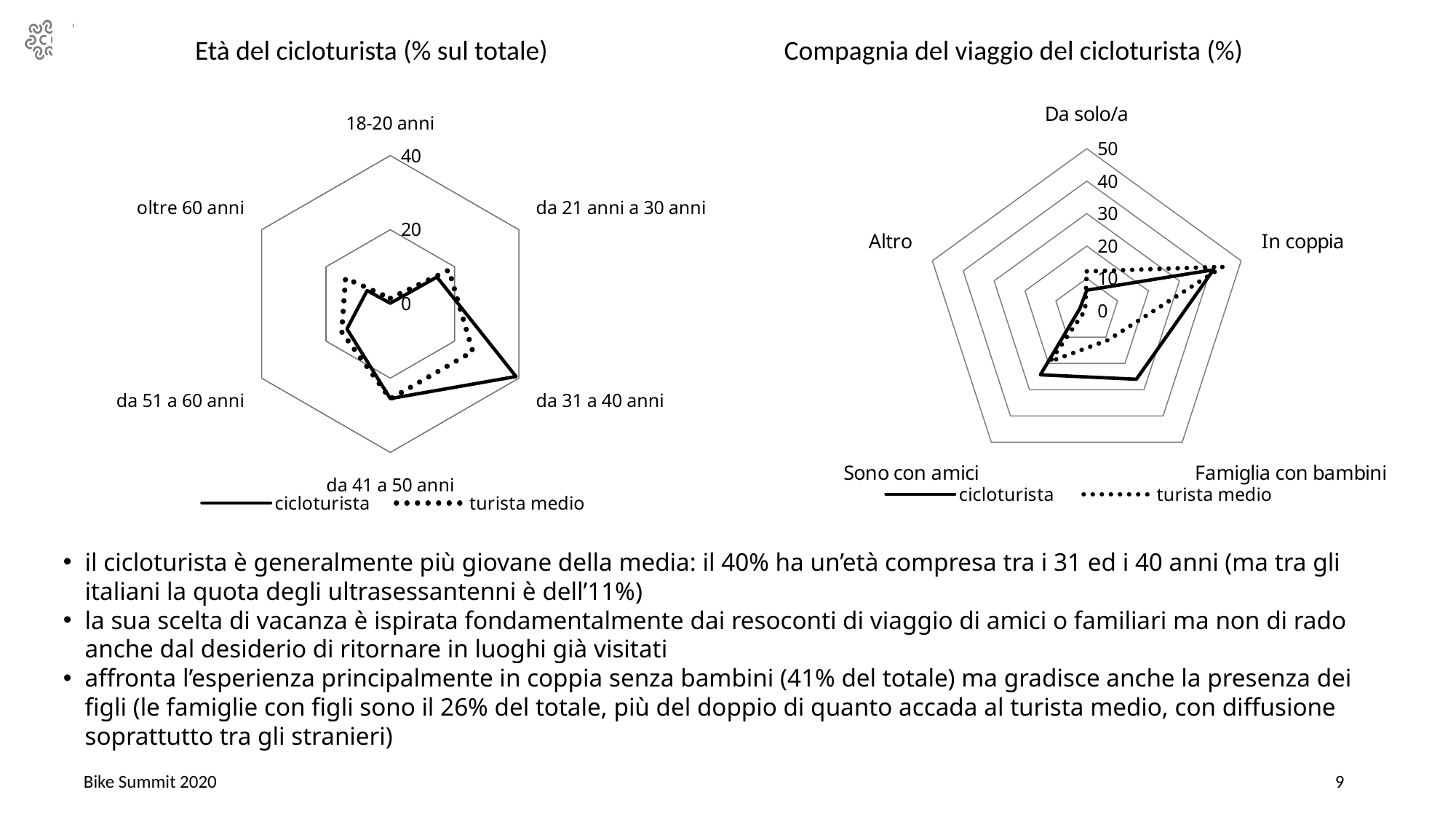
How many categories does the right chart 'Compagnia del viaggio del cicloturista (%)' show? 5 In the left chart 'Età del cicloturista (% sul totale)', is the cicloturista value for da 31 a 40 anni greater or less than 20? greater In the left chart 'Età del cicloturista (% sul totale)', which series has the larger value for oltre 60 anni, cicloturista or turista medio? turista medio In the left chart 'Età del cicloturista (% sul totale)', is the cicloturista value for 18-20 anni greater or less than 20? less In the right chart 'Compagnia del viaggio del cicloturista (%)', which category has the highest value for cicloturista? In coppia How many age categories does the left chart 'Età del cicloturista (% sul totale)' show? 6 How many series does the legend of the right chart 'Compagnia del viaggio del cicloturista (%)' list? 2 In the right chart 'Compagnia del viaggio del cicloturista (%)', which series has the larger value for Famiglia con bambini, cicloturista or turista medio? cicloturista In the right chart 'Compagnia del viaggio del cicloturista (%)', is the cicloturista value for In coppia greater or less than 30? greater What kind of chart is the left chart, 'Età del cicloturista (% sul totale)'? Radar chart In the left chart 'Età del cicloturista (% sul totale)', which age category has the highest value for cicloturista? da 31 a 40 anni